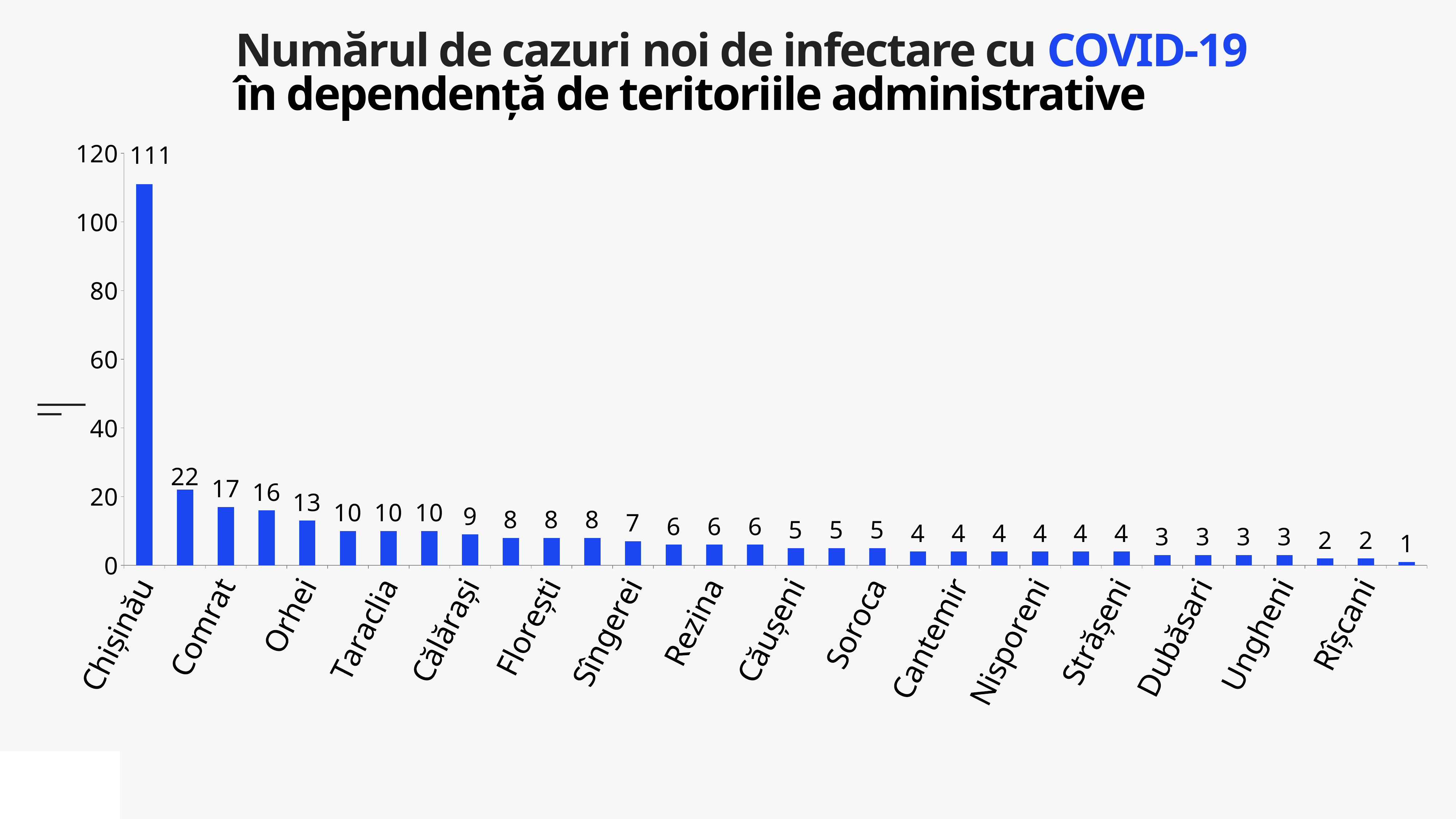
What is the difference between the values for Chișinău and Comrat? 94 Is the value for Chișinău greater or less than 100? greater What is the value for Comrat? 17 What is the value for Florești? 8 Which is larger, the value for Orhei or the value for Florești? Orhei Do the values rise or fall from left to right along the x axis? fall What is the difference between the values for Orhei and Taraclia? 3 What is the value for Rîșcani? 2 What is the value for Orhei? 13 What kind of chart is shown on the slide? bar chart What is the value for Chișinău? 111 Which territory has the highest number of new cases? Chișinău